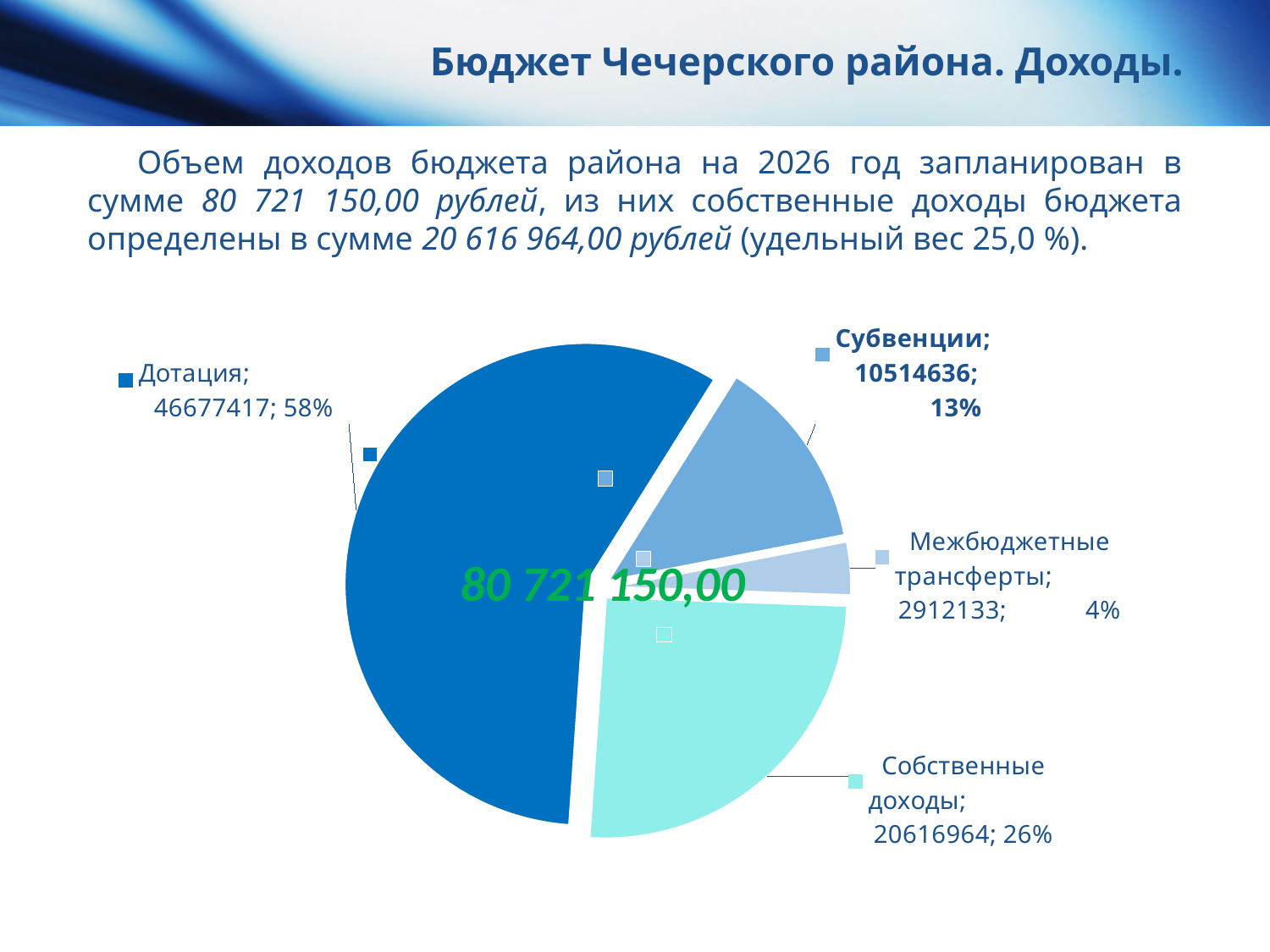
Which is larger in the pie chart, Собственные доходы or Субвенции? Собственные доходы Which category has the smallest slice in the pie chart? Межбюджетные трансферты What total value is printed in the centre of the pie chart? 80 721 150,00 Which category has the largest slice in the pie chart? Дотация What percentage share does Субвенции have in the pie chart? 13% What value is shown for Субвенции in the pie chart? 10514636 How many slices does the pie chart have? 4 What value is shown for Межбюджетные трансферты in the pie chart? 2912133 What percentage share does Собственные доходы have in the pie chart? 26% What kind of chart is shown on the slide? pie chart What percentage share does Дотация have in the pie chart? 58% What value is shown for Дотация in the pie chart? 46677417